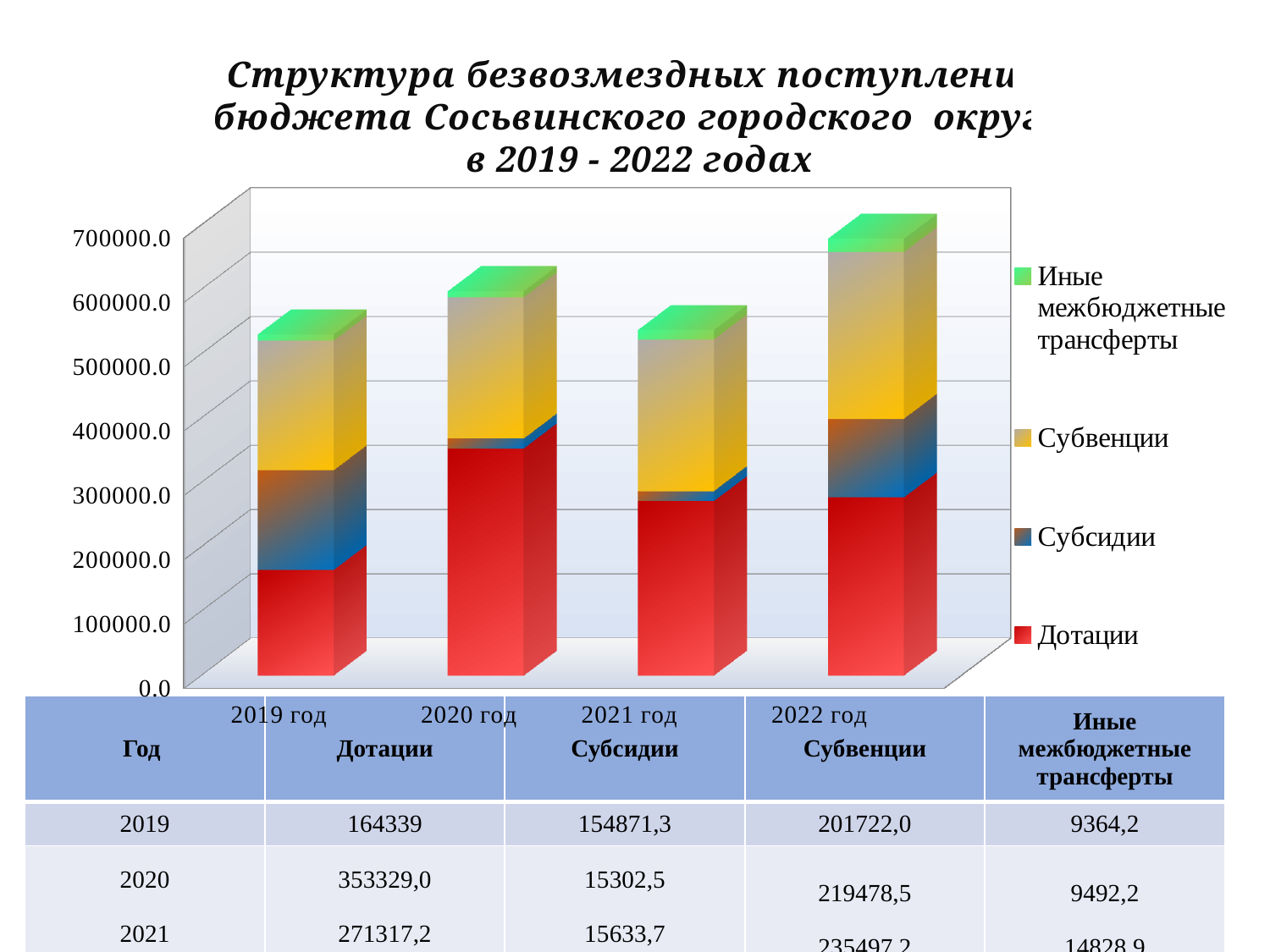
How many years (categories) are shown on the x axis of the chart? 4 Using the table values, what is the total of all four series for 2019? 530296,5 According to the table under the chart, what is the value of Субсидии for 2021? 15633,7 According to the table under the chart, what is the value of Дотации for 2019? 164339 Which is larger, Дотации in 2019 or Дотации in 2020? 2020 Which colour represents Дотации in the chart? Red What kind of chart is shown on the slide? Stacked bar chart Is the total stacked bar for 2019 год greater or less than 600000? less How many series does the chart legend list? 4 According to the table under the chart, what is the value of Субвенции for 2020? 219478,5 Which year has the tallest stacked bar in the chart? 2022 год Is the total stacked bar for 2022 год greater or less than 600000? greater